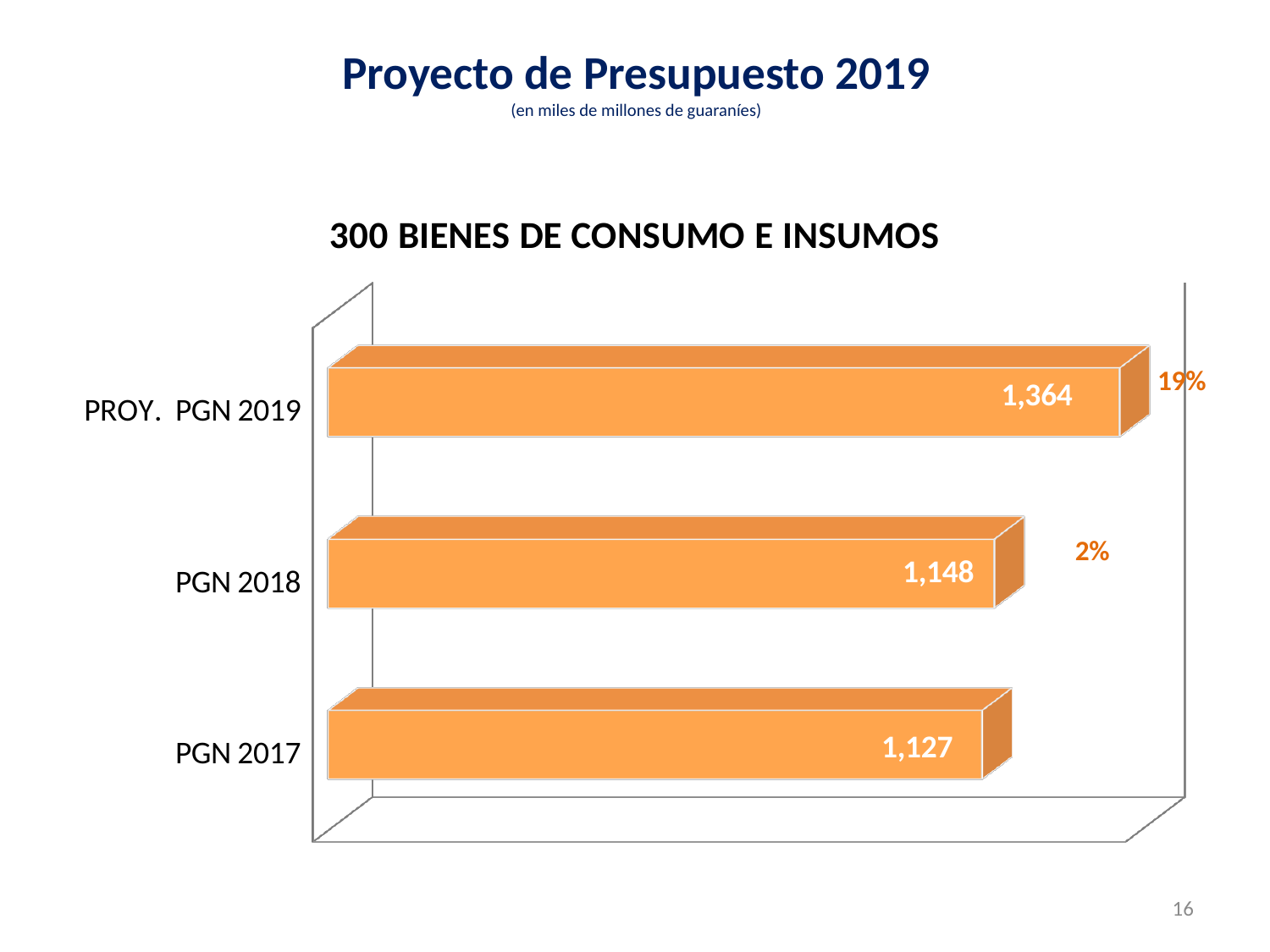
What is the value for PGN 2018? 1,148 What is the value for PROY. PGN 2019? 1,364 What percentage change is shown next to the PROY. PGN 2019 bar? 19% What kind of chart is shown on the slide? Bar chart How many categories are shown in the chart? 3 Which category has the lowest value? PGN 2017 What is the difference between the values for PGN 2018 and PGN 2017? 21 Which category has the highest value? PROY. PGN 2019 Which is larger, the value for PROY. PGN 2019 or the value for PGN 2018? PROY. PGN 2019 What is the difference between the values for PROY. PGN 2019 and PGN 2018? 216 What is the title of the chart? 300 BIENES DE CONSUMO E INSUMOS What is the value for PGN 2017? 1,127